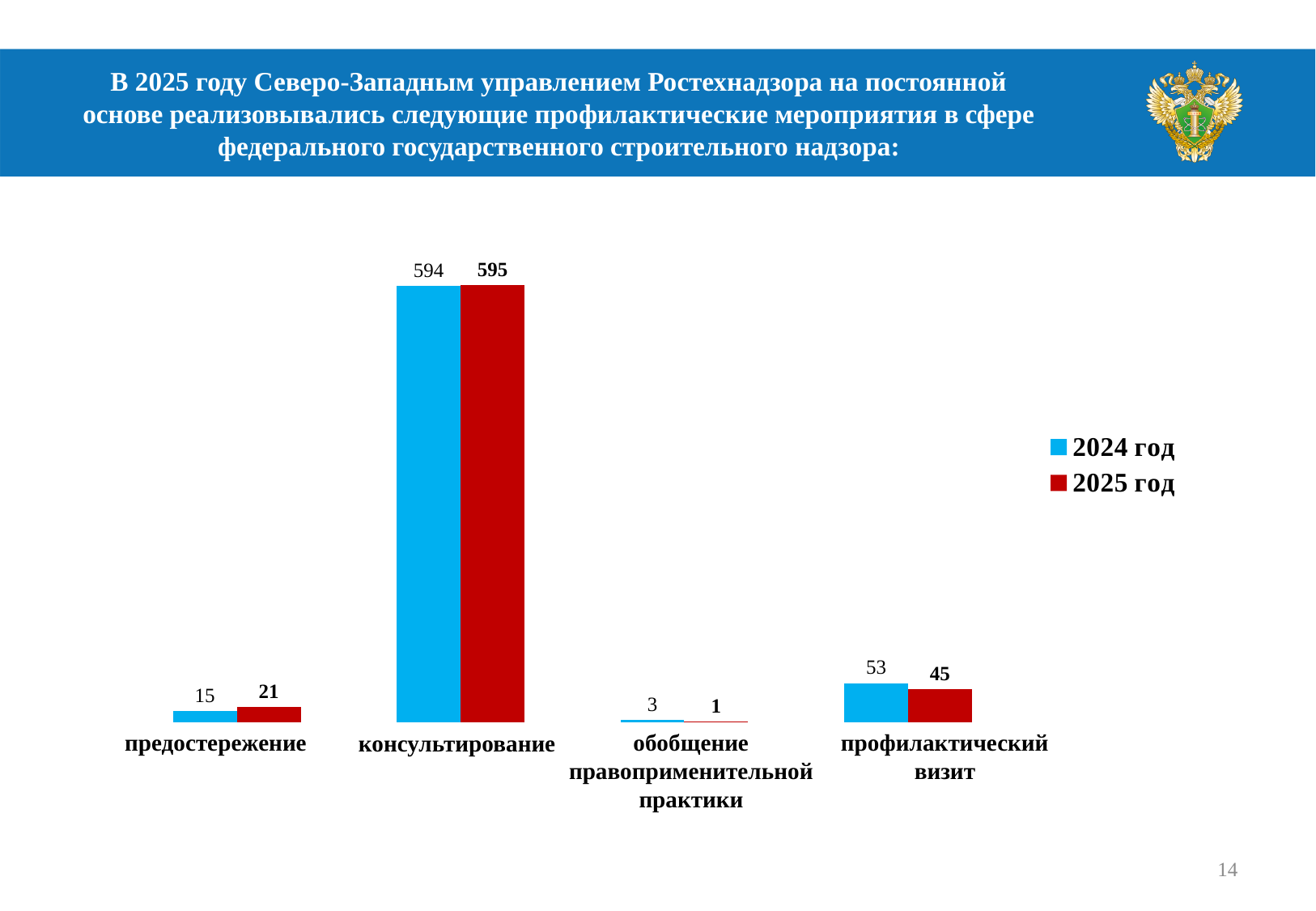
What is the difference between the 2024 год and 2025 год values for профилактический визит? 8 What is the value for предостережение in 2025 год? 21 What is the difference between the 2025 год and 2024 год values for предостережение? 6 Which category has the highest value in 2025 год? консультирование Which category has the lowest value in 2024 год? обобщение правоприменительной практики What is the value for профилактический визит in 2024 год? 53 How many categories are shown on the x axis? 4 Which is larger for профилактический визит: the 2024 год value or the 2025 год value? 2024 год What is the value for обобщение правоприменительной практики in 2025 год? 1 What is the value for консультирование in 2024 год? 594 How many series does the legend list? 2 What kind of chart is shown on the slide? bar chart